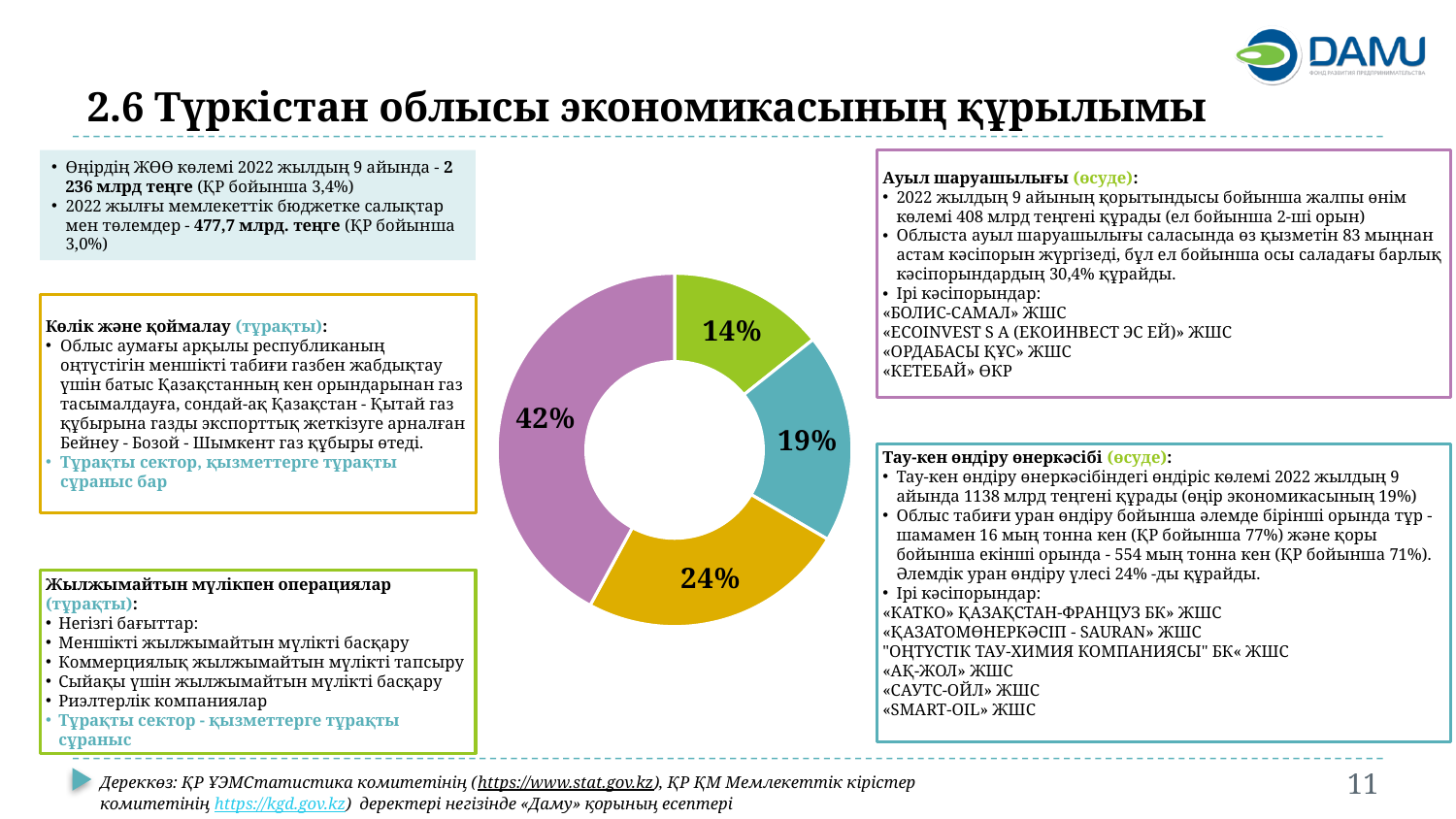
What do the four labelled slices of the pie chart add up to? 99% What is the difference between the largest slice (42%) and the smallest slice (14%) in the pie chart? 28% What is the smallest percentage shown on the pie chart? 14% How many slices does the pie chart have? 4 What percentage is labelled on the green slice of the pie chart? 14% What kind of chart is shown on the slide? pie chart (donut) Does the pie chart have a legend? No What is the largest percentage shown on the pie chart? 42% What percentage is labelled on the teal (blue) slice of the pie chart? 19% What percentage is labelled on the yellow slice of the pie chart? 24% What percentage is labelled on the purple slice of the pie chart? 42% Which slice is larger in the pie chart, the yellow one or the teal one? the yellow one (24%)